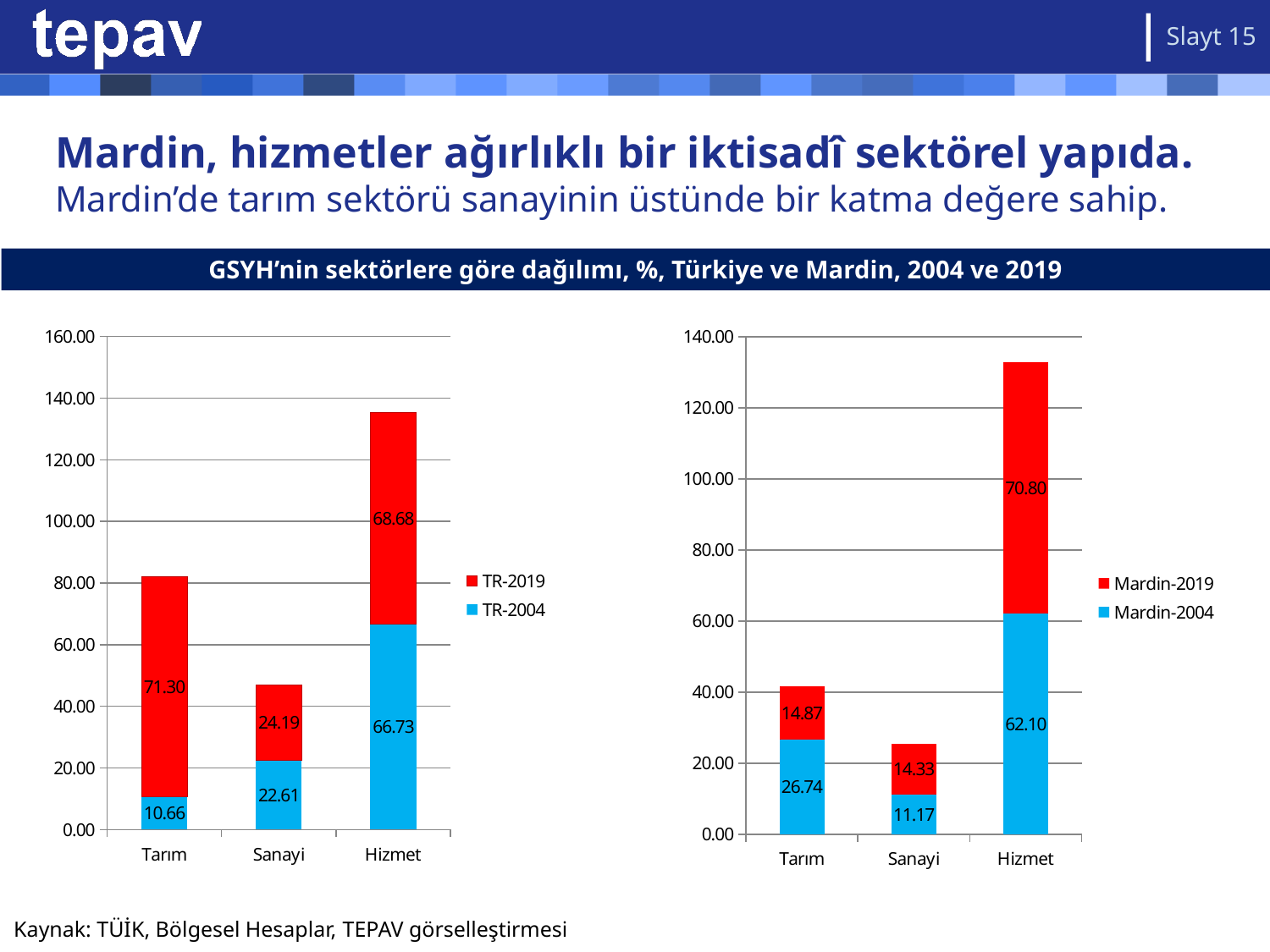
In the right chart (Mardin-2004/Mardin-2019), which is larger for Sanayi: the Mardin-2004 value or the Mardin-2019 value? Mardin-2019 In the right chart (Mardin-2004/Mardin-2019), what is the difference between the Mardin-2004 and Mardin-2019 values for Tarım? 11.87 In the left chart (TR-2004/TR-2019), what is the TR-2004 value for Tarım? 10.66 What type of chart is the right chart (Mardin-2004/Mardin-2019)? Stacked bar chart In the right chart (Mardin-2004/Mardin-2019), what is the Mardin-2019 value for Sanayi? 14.33 In the left chart (TR-2004/TR-2019), which category has the lowest TR-2004 value? Tarım In the right chart (Mardin-2004/Mardin-2019), what is the total height of the stacked bar for Hizmet? 132.90 In the left chart (TR-2004/TR-2019), what is the total height of the stacked bar for Sanayi? 46.80 How many series does the legend of the left chart list? 2 In the right chart (Mardin-2004/Mardin-2019), what is the Mardin-2004 value for Hizmet? 62.10 In the right chart (Mardin-2004/Mardin-2019), which category has the highest Mardin-2019 value? Hizmet In the left chart (TR-2004/TR-2019), what is the TR-2019 value for Hizmet? 68.68